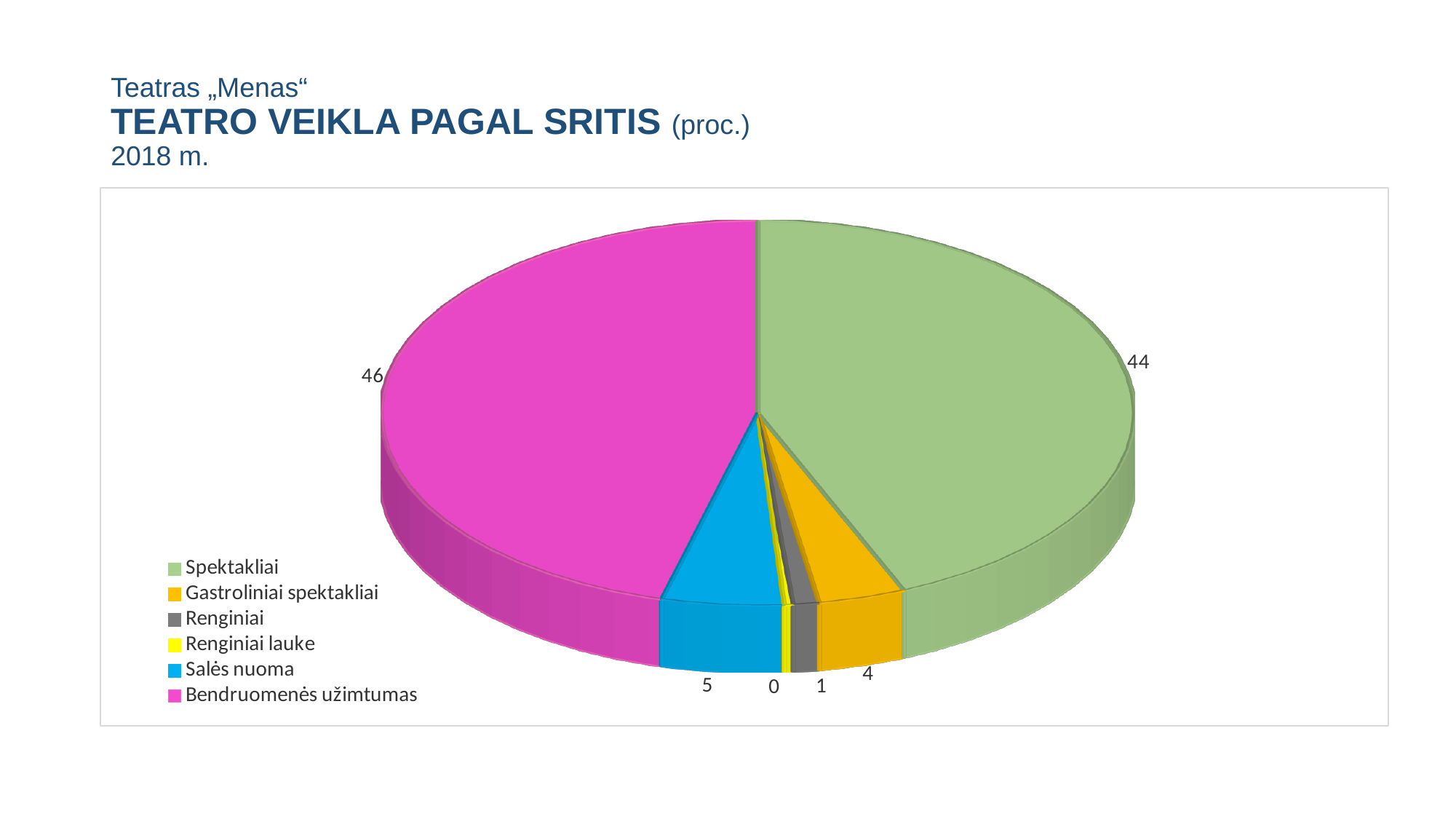
How many categories does the legend list? 6 What is the difference between the values for Bendruomenės užimtumas and Spektakliai? 2 Which colour represents Renginiai in the legend? grey What is the value for Renginiai lauke? 0 What is the value for Bendruomenės užimtumas? 46 Which category has the largest share of the pie? Bendruomenės užimtumas What is the value for Gastroliniai spektakliai? 4 What kind of chart is shown on the slide? pie chart What is the value for Salės nuoma? 5 Which category has the smallest share of the pie? Renginiai lauke What is the value for Spektakliai? 44 Which is larger, the value for Salės nuoma or the value for Gastroliniai spektakliai? Salės nuoma